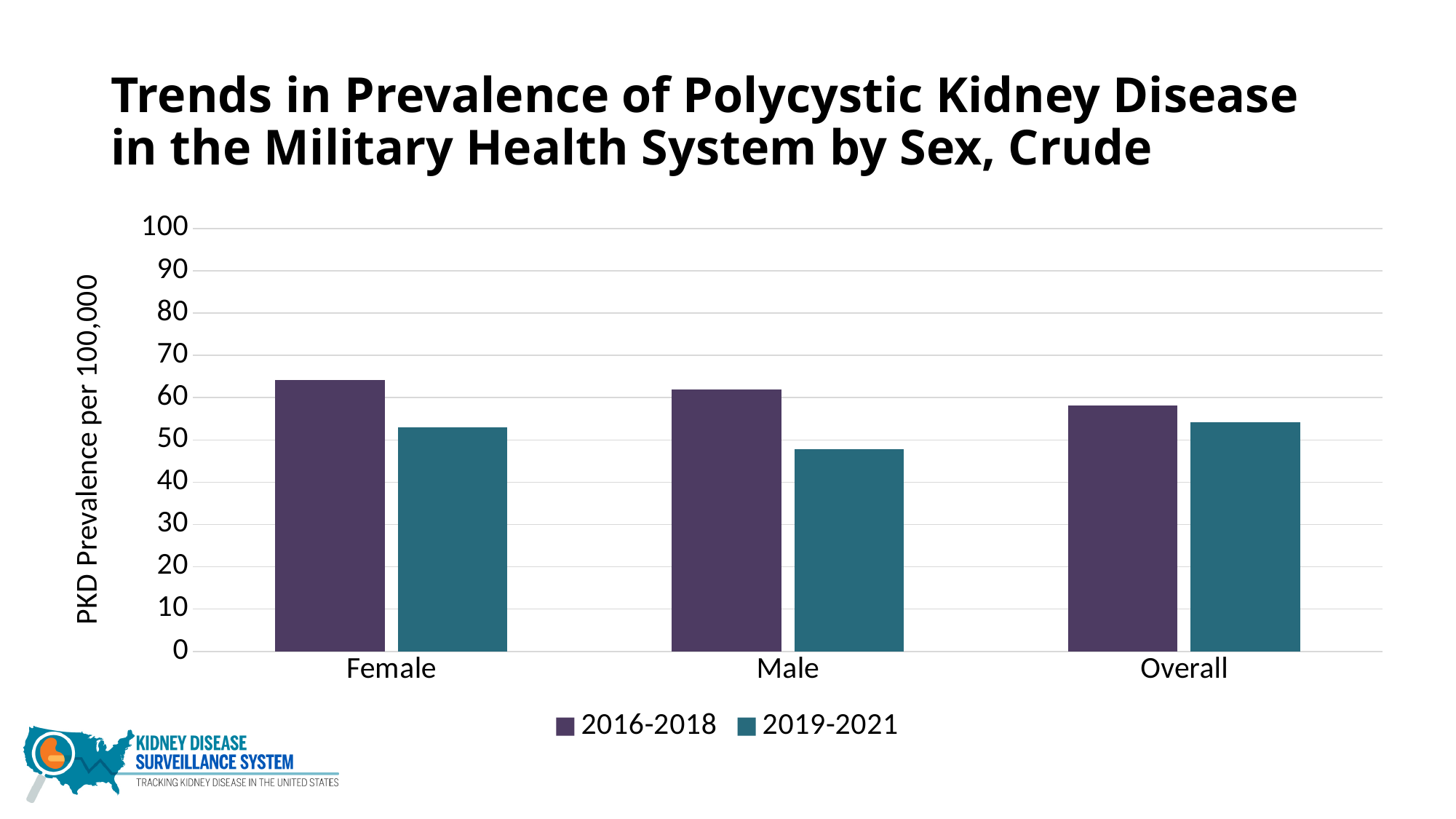
For Female, which period has the larger value, 2016-2018 or 2019-2021? 2016-2018 What kind of chart is shown on the slide? bar chart How many series does the legend list? 2 Is the value for Male in 2016-2018 greater or less than 70? less What are the two series listed in the legend? 2016-2018 and 2019-2021 Is the value for Male in 2019-2021 greater or less than 50? less What is the label of the y axis? PKD Prevalence per 100,000 Which category has the lowest value in the 2019-2021 series? Male Is the value for Female in 2019-2021 greater or less than 50? greater How many categories are shown on the x axis? 3 Which category has the lowest value in the 2016-2018 series? Overall